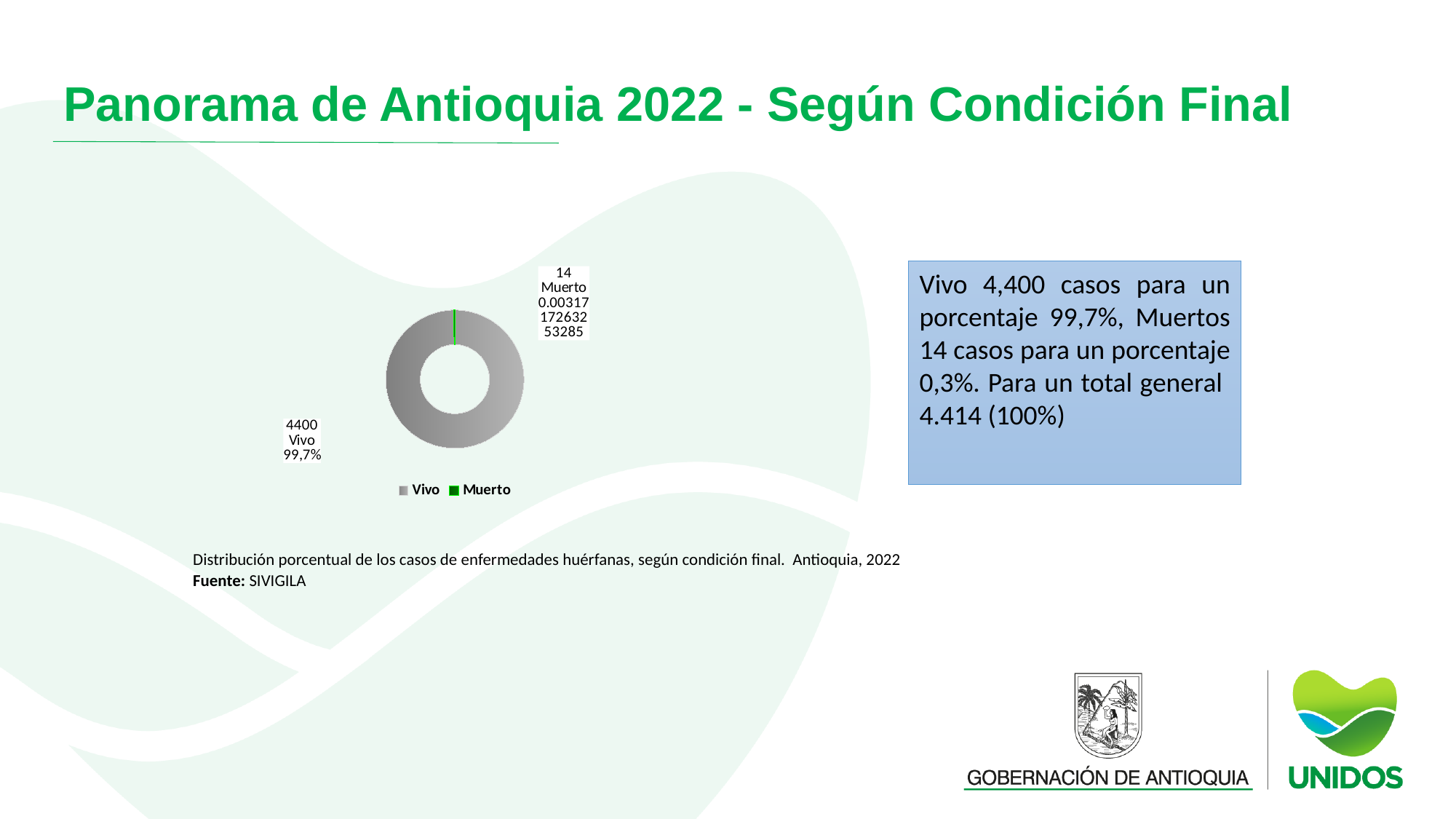
How many entries does the legend of the doughnut chart list? 2 What is the difference in cases between Vivo and Muerto in the doughnut chart? 4386 Which category has more cases in the doughnut chart, Vivo or Muerto? Vivo What is the total number of cases across both categories in the doughnut chart? 4414 What percentage is shown for Vivo in the doughnut chart? 99,7% Which category has the largest share of the doughnut chart? Vivo What is the number of cases shown for Muerto in the doughnut chart? 14 How many categories does the doughnut chart show? 2 What kind of chart is shown on the slide? Doughnut chart Which colour represents Muerto in the doughnut chart legend? Green Which category has the smallest share of the doughnut chart? Muerto What is the number of cases shown for Vivo in the doughnut chart? 4400